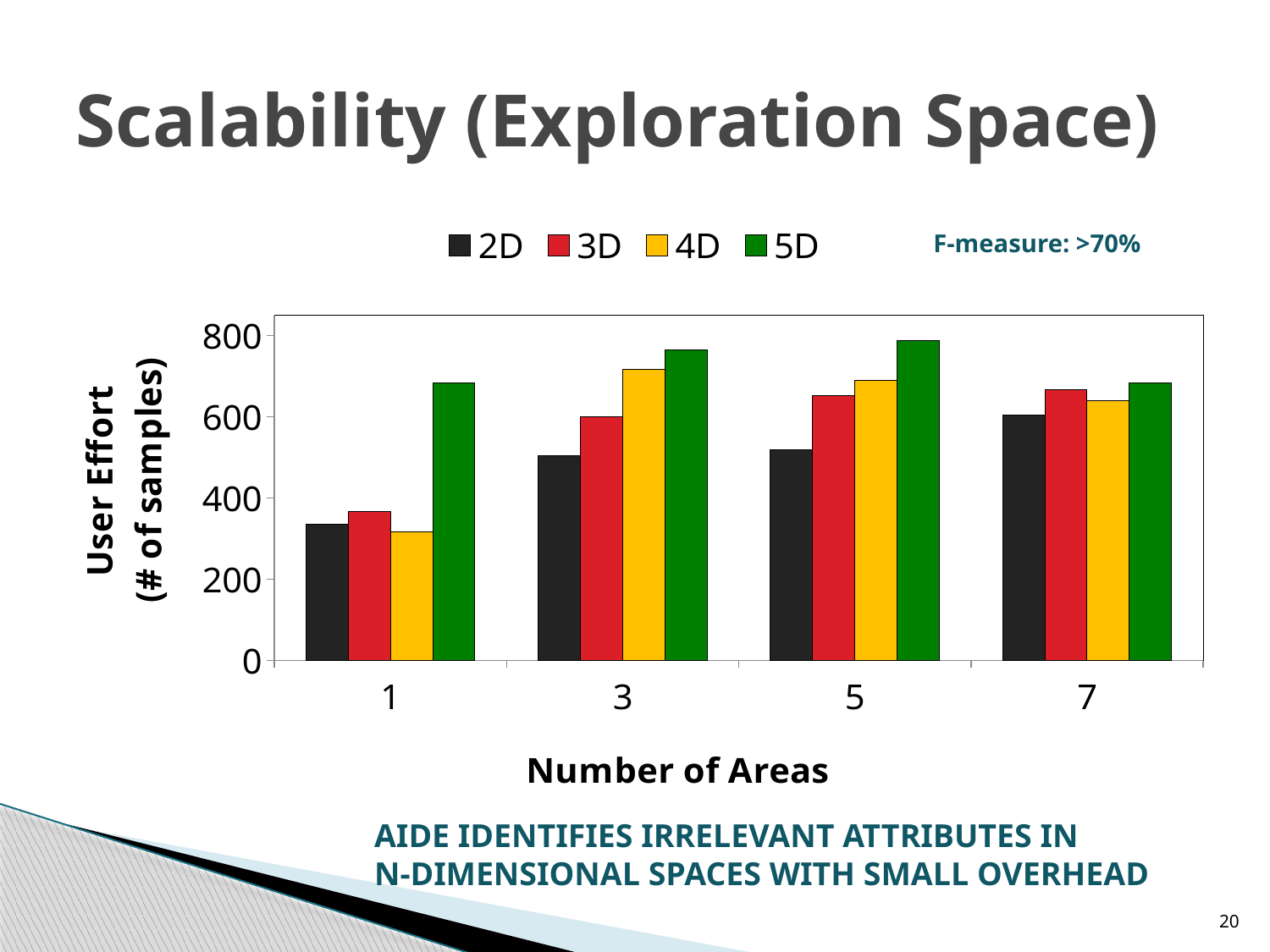
Is the 4D value at 3 areas greater or less than 600? greater Which series has the highest user effort when the number of areas is 3? 5D Is the 5D value at 1 area greater or less than 600? greater What is the title of the x axis? Number of Areas Is the 2D value at 3 areas greater or less than 600? less Which is larger: the 5D value at 5 areas or the 5D value at 7 areas? 5 areas What type of chart is shown on the slide? bar chart For the 5D series, at which number of areas is user effort lowest? 1 How many series does the legend list? 4 Which series has the highest user effort when the number of areas is 1? 5D How many Number of Areas categories are shown on the x axis? 4 Does the 2D series rise or fall as the number of areas increases from 1 to 7? rises